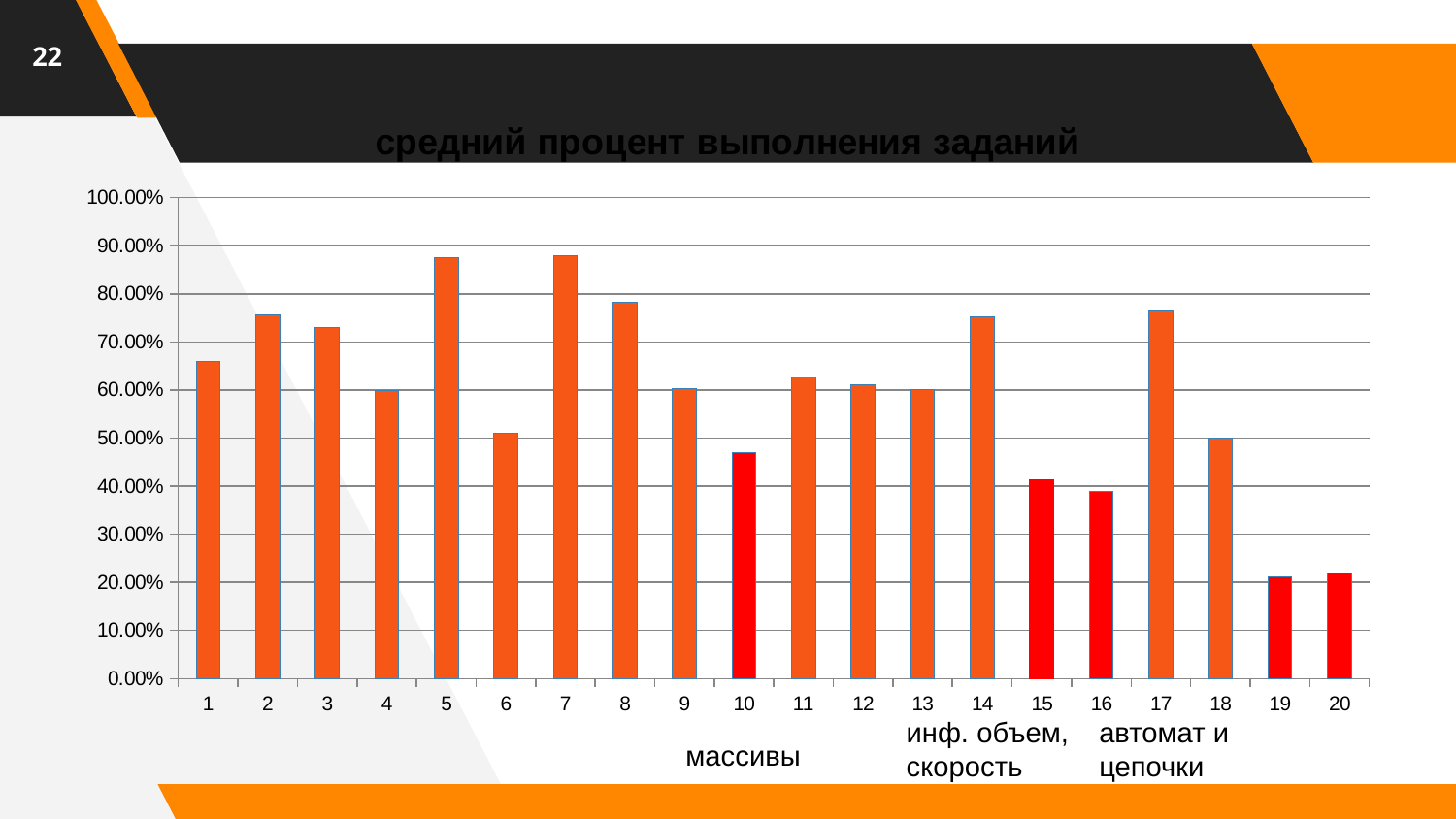
What is the title of the chart? средний процент выполнения заданий What kind of chart is shown on the slide? bar chart Which has the higher value, task 2 or task 4? task 2 Is the value for task 5 greater or less than 80.00%? greater Which has the higher value, task 14 or task 18? task 14 Which has the lower value, task 7 or task 10? task 10 Is the value for task 19 greater or less than 30.00%? less Is the value for task 10 greater or less than 50.00%? less How many bars are coloured red instead of orange? 5 How many categories (tasks) are plotted on the x axis? 20